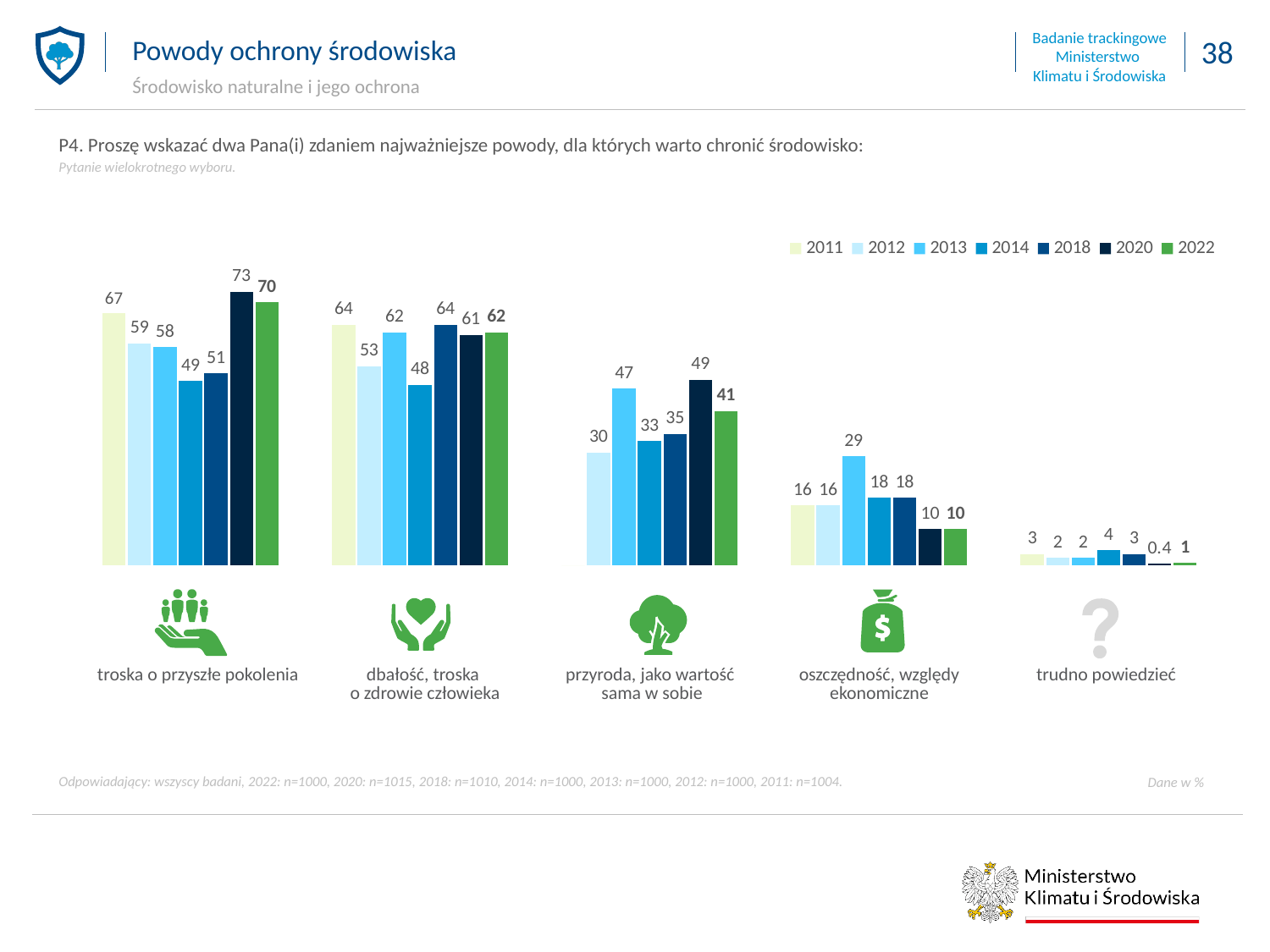
What is the difference between the 2020 and 2022 values for 'przyroda, jako wartość sama w sobie'? 8 Which is larger for 2022: 'troska o przyszłe pokolenia' or 'dbałość, troska o zdrowie człowieka'? troska o przyszłe pokolenia What is the 2022 value for 'troska o przyszłe pokolenia'? 70 What is the 2020 value for 'trudno powiedzieć'? 0.4 What kind of chart is shown on the slide? bar chart What is the 2013 value for 'oszczędność, względy ekonomiczne'? 29 Which year has the lowest value for 'dbałość, troska o zdrowie człowieka'? 2014 What is the difference between the 2011 and 2014 values for 'troska o przyszłe pokolenia'? 18 How many series does the legend list? 7 Which category has the lowest 2022 value? trudno powiedzieć Which year has the highest value for 'troska o przyszłe pokolenia'? 2020 How many response categories are shown along the x axis? 5